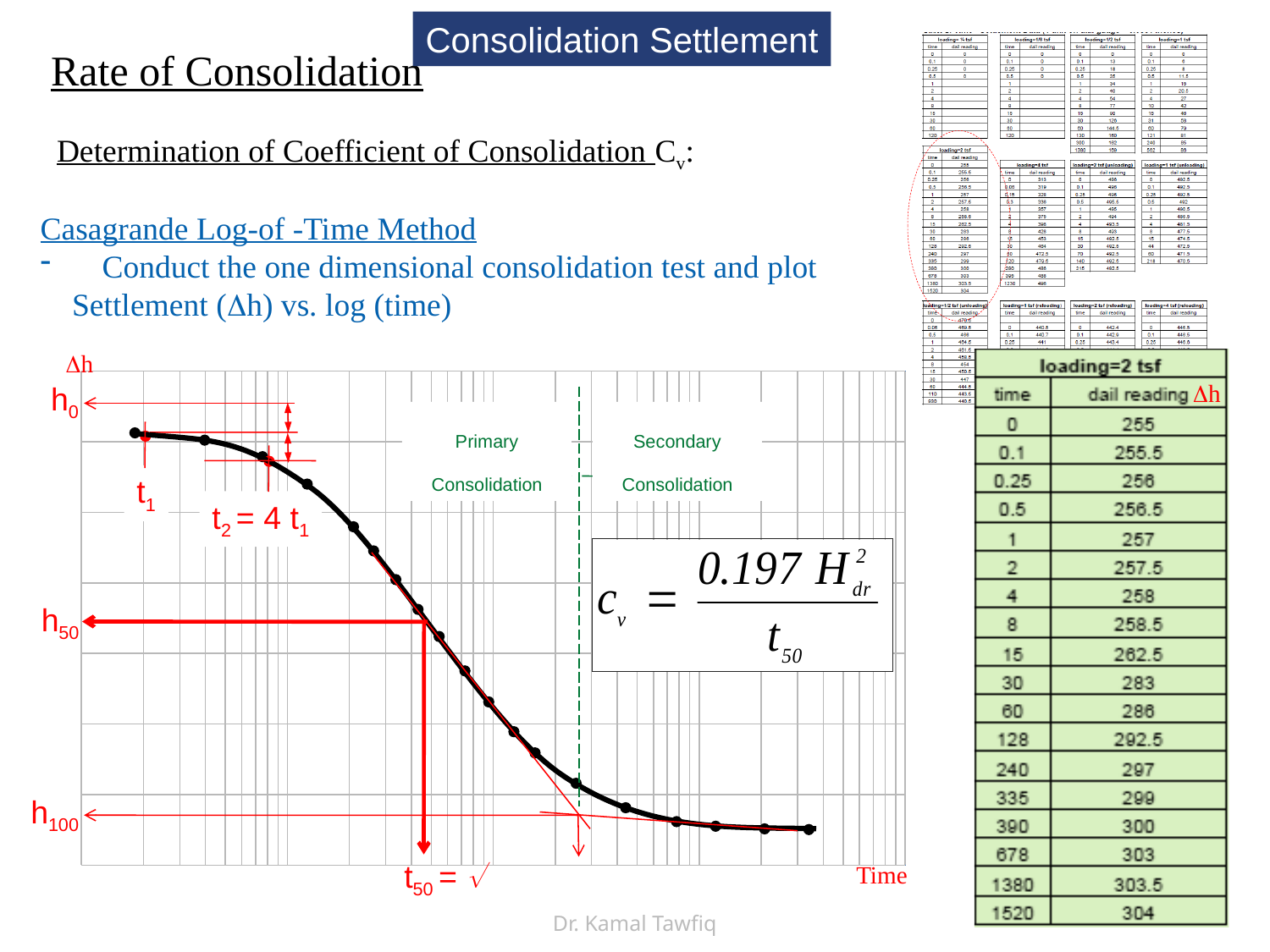
In the loading=2 tsf data table, what is the dial reading at time 1520? 304 In the loading=2 tsf data table, which is larger, the dial reading at time 60 or at time 128? 128 How many time readings are listed in the loading=2 tsf data table? 18 In the loading=2 tsf data table, what is the difference between the dial reading at time 1520 and at time 0? 49 In the loading=2 tsf data table, what is the dial reading at time 0? 255 In the loading=2 tsf data table, at which time is the dial reading highest? 1520 What kind of chart is the settlement versus time plot on the slide? line chart In the loading=2 tsf data table, what is the dial reading at time 30? 283 Which consolidation region is labelled to the left of the dashed vertical line on the chart? Primary Consolidation What is the label on the horizontal axis of the settlement curve chart? Time Do the plotted values on the settlement curve rise or fall as time increases along the x axis? fall